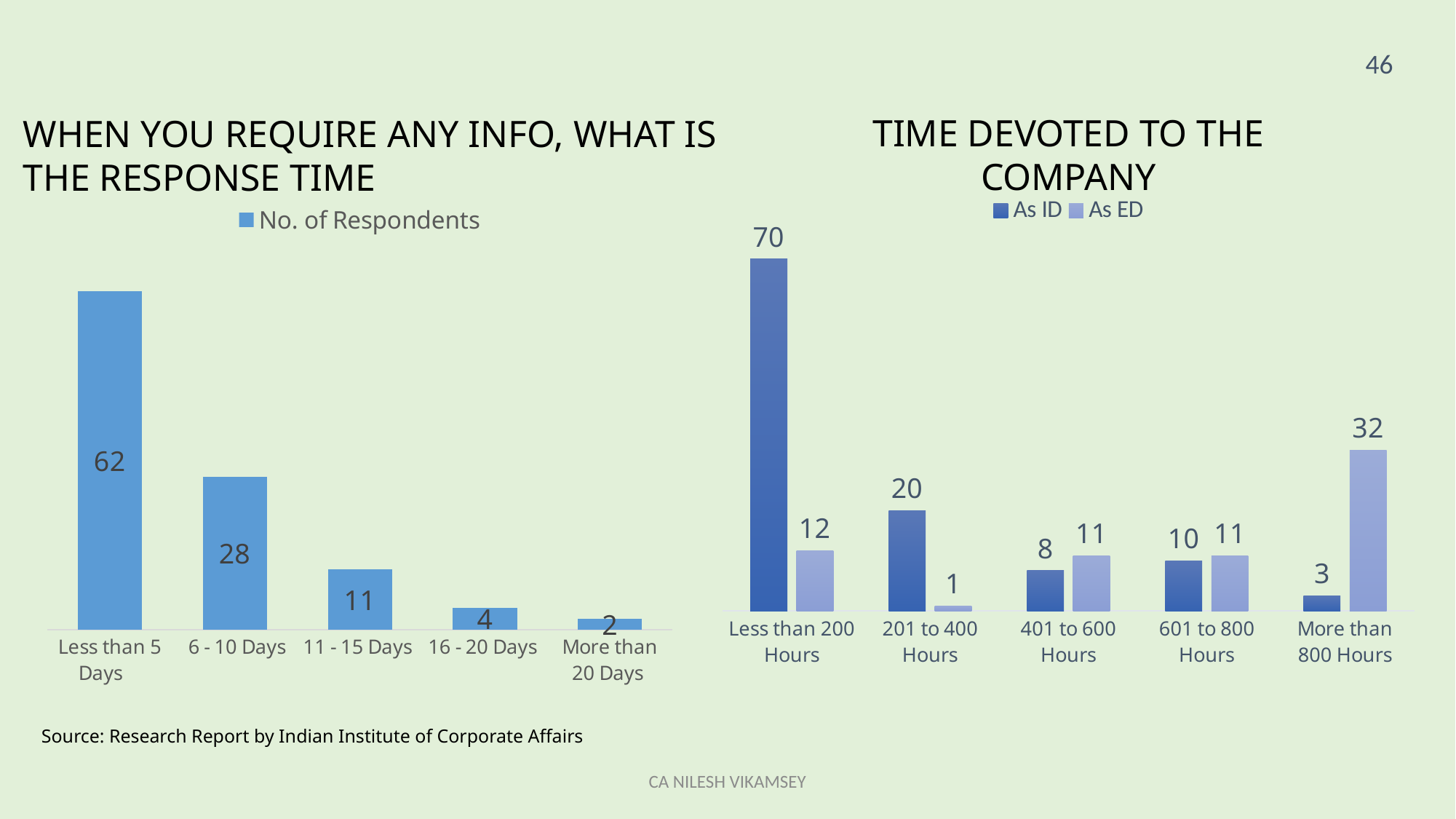
In the 'When you require any info, what is the response time' chart, what is the number of respondents for 'Less than 5 Days'? 62 In the 'When you require any info, what is the response time' chart, which category has the lowest number of respondents? More than 20 Days In the 'Time devoted to the company' chart, which category has the highest 'As ED' value? More than 800 Hours In the 'Time devoted to the company' chart, which is larger for '401 to 600 Hours': the 'As ID' value or the 'As ED' value? As ED In the 'Time devoted to the company' chart, what is the 'As ED' value for 'More than 800 Hours'? 32 In the 'When you require any info, what is the response time' chart, what is the difference between the values for '6 - 10 Days' and '11 - 15 Days'? 17 In the 'When you require any info, what is the response time' chart, do the values rise or fall from left to right along the x axis? fall In the 'Time devoted to the company' chart, what is the 'As ID' value for '201 to 400 Hours'? 20 What kind of chart is the 'Time devoted to the company' chart? bar chart How many series does the legend of the 'Time devoted to the company' chart list? 2 In the 'When you require any info, what is the response time' chart, how many categories are shown on the x axis? 5 In the 'Time devoted to the company' chart, what is the difference between the 'As ID' and 'As ED' values for 'Less than 200 Hours'? 58